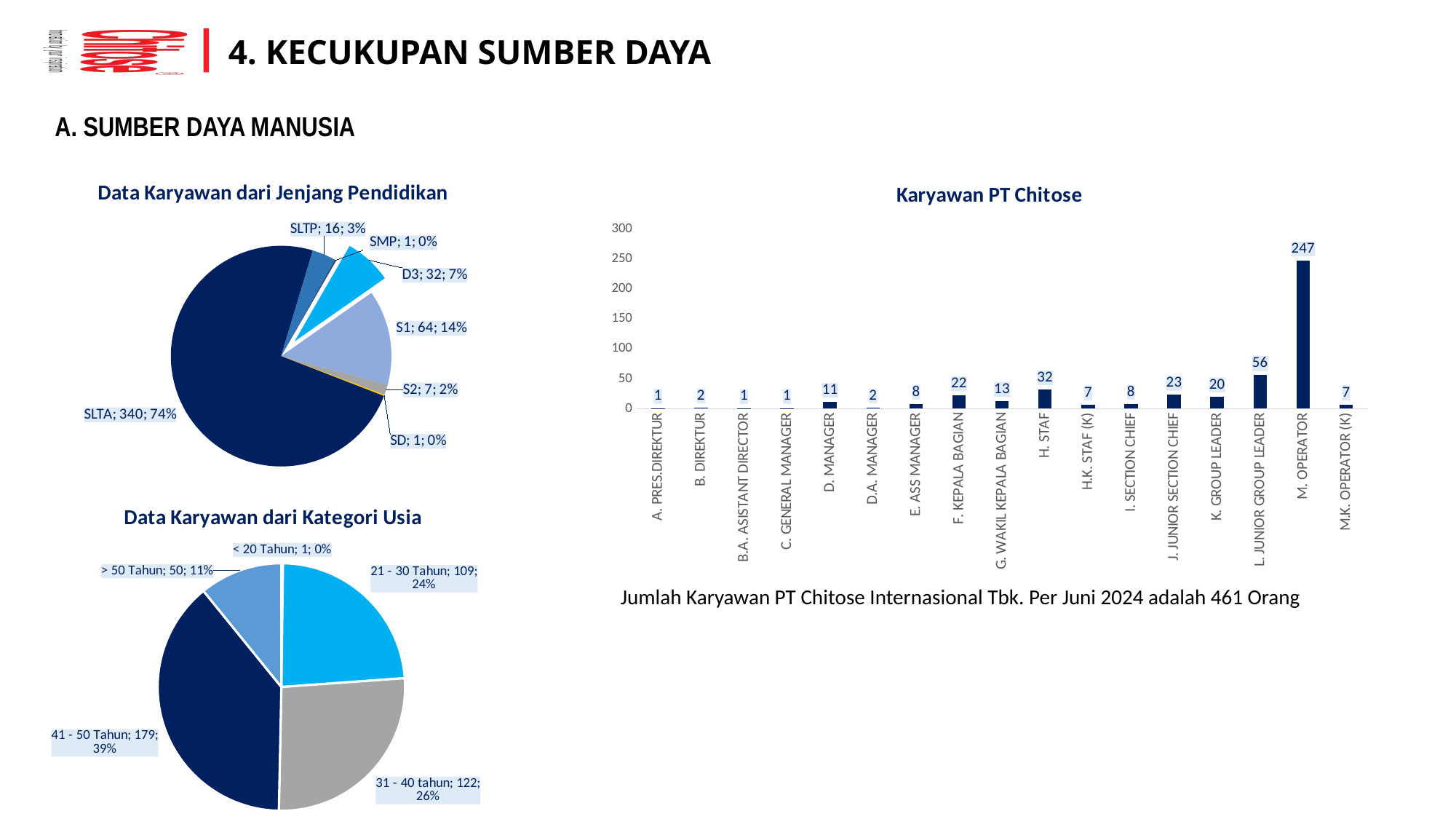
What kind of chart is 'Data Karyawan dari Kategori Usia'? Pie chart In the 'Data Karyawan dari Kategori Usia' pie chart, what is the difference between 41 - 50 Tahun and 21 - 30 Tahun? 70 In the 'Karyawan PT Chitose' bar chart, what is the difference between L. JUNIOR GROUP LEADER and H. STAF? 24 In the 'Karyawan PT Chitose' bar chart, what is the value for M. OPERATOR? 247 In the 'Data Karyawan dari Jenjang Pendidikan' pie chart, which category has the largest slice? SLTA In the 'Karyawan PT Chitose' bar chart, which category has the highest value? M. OPERATOR What kind of chart is 'Karyawan PT Chitose'? Bar chart In the 'Karyawan PT Chitose' bar chart, which is larger: F. KEPALA BAGIAN or J. JUNIOR SECTION CHIEF? J. JUNIOR SECTION CHIEF In the 'Data Karyawan dari Jenjang Pendidikan' pie chart, what share does SLTA have? 74% In the 'Data Karyawan dari Jenjang Pendidikan' pie chart, what is the value for S1? 64 In the 'Data Karyawan dari Kategori Usia' pie chart, what is the value for 31 - 40 tahun? 122 In the 'Karyawan PT Chitose' bar chart, how many categories are shown on the x axis? 17